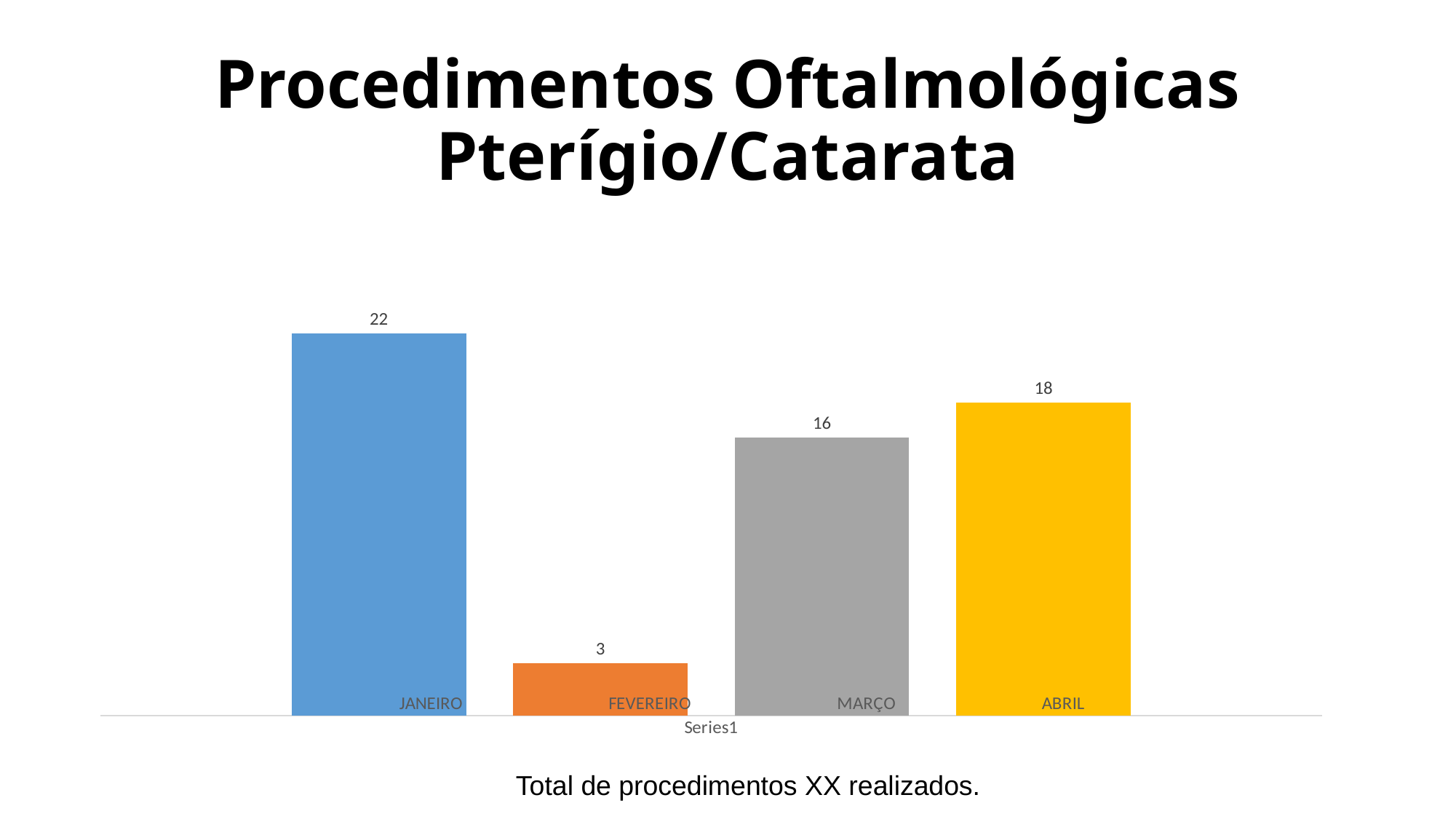
What kind of chart is shown on the slide? bar chart Which month has the highest value? JANEIRO What is the difference between the values for JANEIRO and ABRIL? 4 What is the difference between the values for MARÇO and FEVEREIRO? 13 Which is larger, the value for MARÇO or the value for ABRIL? ABRIL What is the value for FEVEREIRO? 3 What is the value for JANEIRO? 22 How many months are shown in the chart? 4 What is the value for MARÇO? 16 What is the title of the slide? Procedimentos Oftalmológicas Pterígio/Catarata Which month has the lowest value? FEVEREIRO What is the value for ABRIL? 18